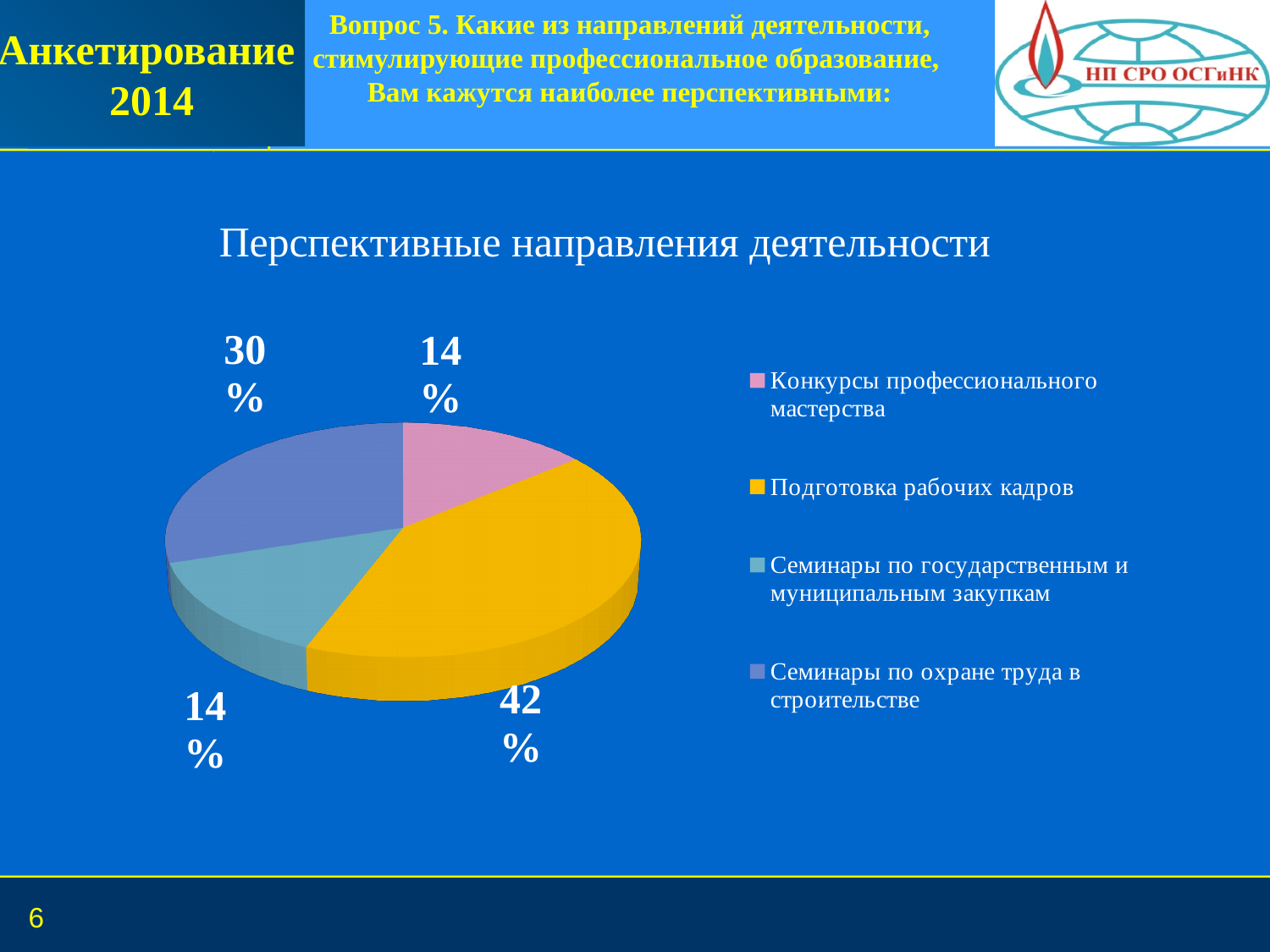
What kind of chart is shown on the slide? pie chart What share of the pie is 'Семинары по государственным и муниципальным закупкам'? 14% What share of the pie is 'Семинары по охране труда в строительстве'? 30% Which category has the largest slice of the pie? Подготовка рабочих кадров What is the difference between the shares of 'Подготовка рабочих кадров' and 'Семинары по охране труда в строительстве'? 12% What share of the pie is 'Подготовка рабочих кадров'? 42% What colour is the slice for 'Подготовка рабочих кадров'? yellow What is the title of the chart? Перспективные направления деятельности How many entries does the legend list? 4 How many slices does the pie chart have? 4 Which is larger: the share of 'Семинары по охране труда в строительстве' or the share of 'Конкурсы профессионального мастерства'? Семинары по охране труда в строительстве